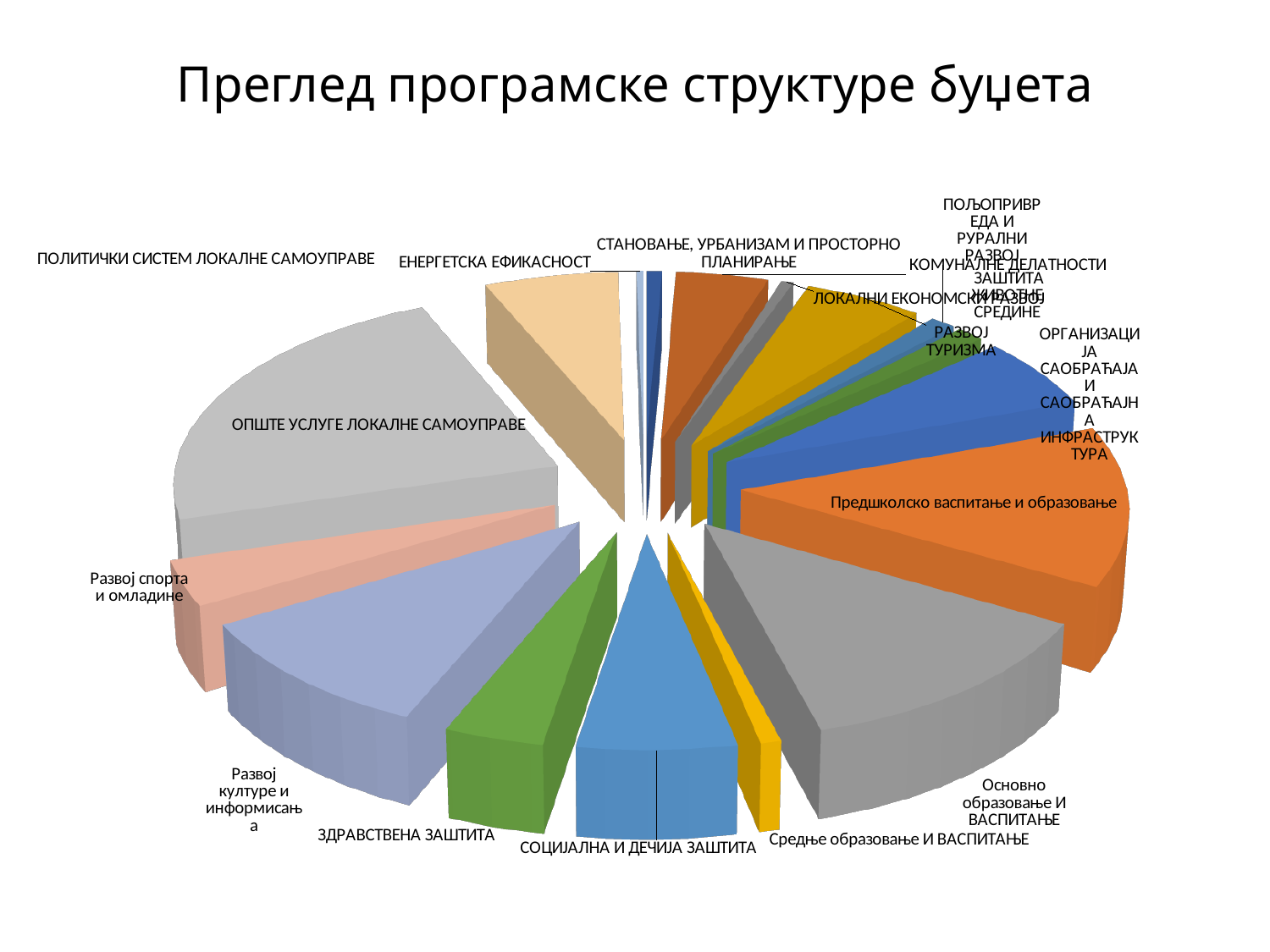
Which slice is larger: Развој културе и информисања or Развој спорта и омладине? Развој културе и информисања Which slice is larger: ЕНЕРГЕТСКА ЕФИКАСНОСТ or ПОЛИТИЧКИ СИСТЕМ ЛОКАЛНЕ САМОУПРАВЕ? ПОЛИТИЧКИ СИСТЕМ ЛОКАЛНЕ САМОУПРАВЕ What kind of chart is shown on the slide? pie chart Which slice is larger: Предшколско васпитање и образовање or Средње образовање И ВАСПИТАЊЕ? Предшколско васпитање и образовање Which category has the largest slice in the pie chart? ОПШТЕ УСЛУГЕ ЛОКАЛНЕ САМОУПРАВЕ What colour is the slice for Предшколско васпитање и образовање? orange What is the title of the chart on the slide? Преглед програмске структуре буџета